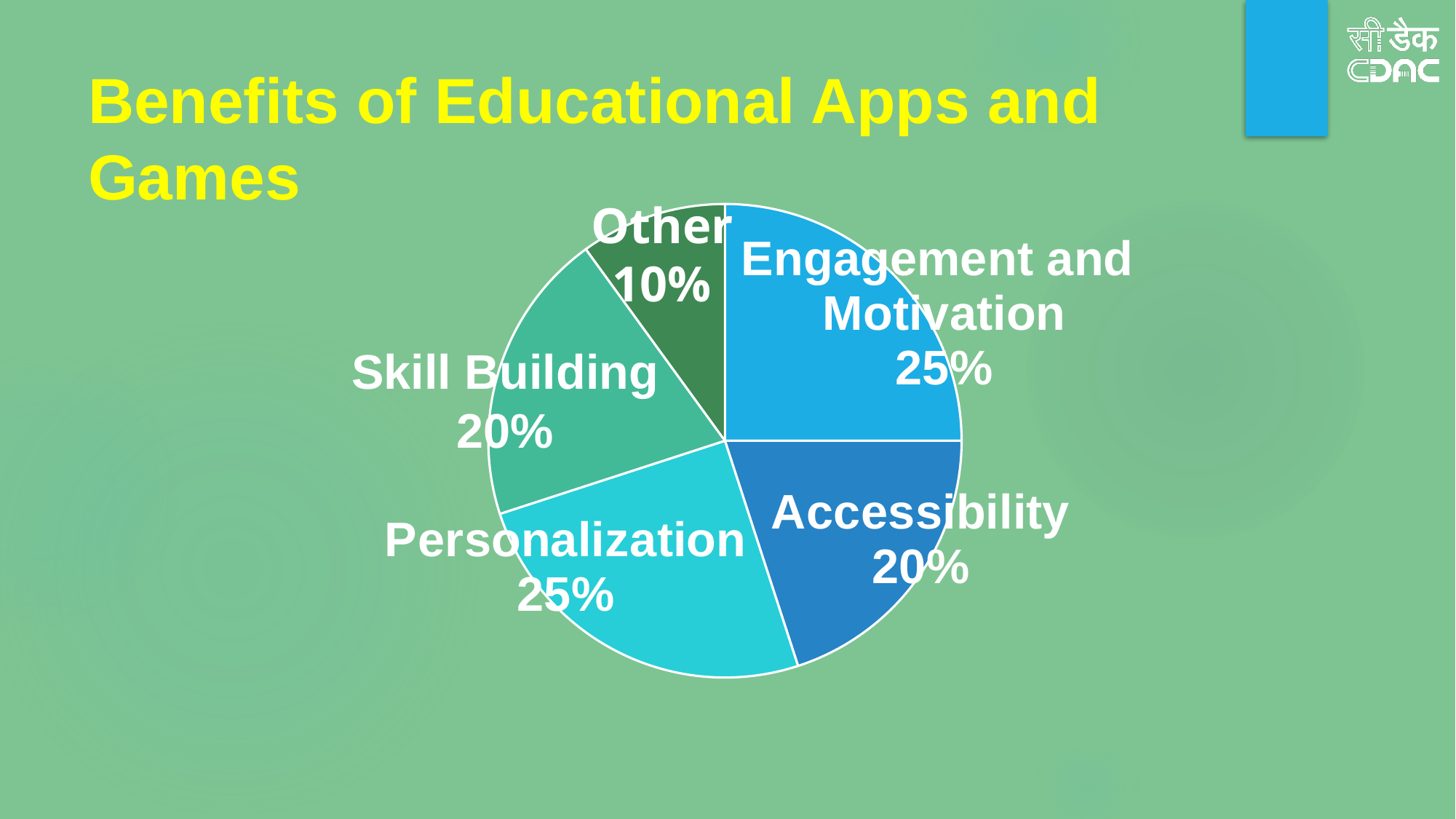
Which is larger, Skill Building or Other? Skill Building What is the title of the slide containing the pie chart? Benefits of Educational Apps and Games How many slices does the pie chart have? 5 What is the difference between the Engagement and Motivation share and the Accessibility share? 5% What is the value shown for Accessibility? 20% What is the value shown for Skill Building? 20% What colour is the Other slice of the pie chart? Dark green Which slice of the pie is the smallest? Other What is the value shown for Personalization? 25% What share of the pie does Engagement and Motivation represent? 25% What is the difference between the Personalization share and the Other share? 15% What type of chart is shown on the slide? Pie chart